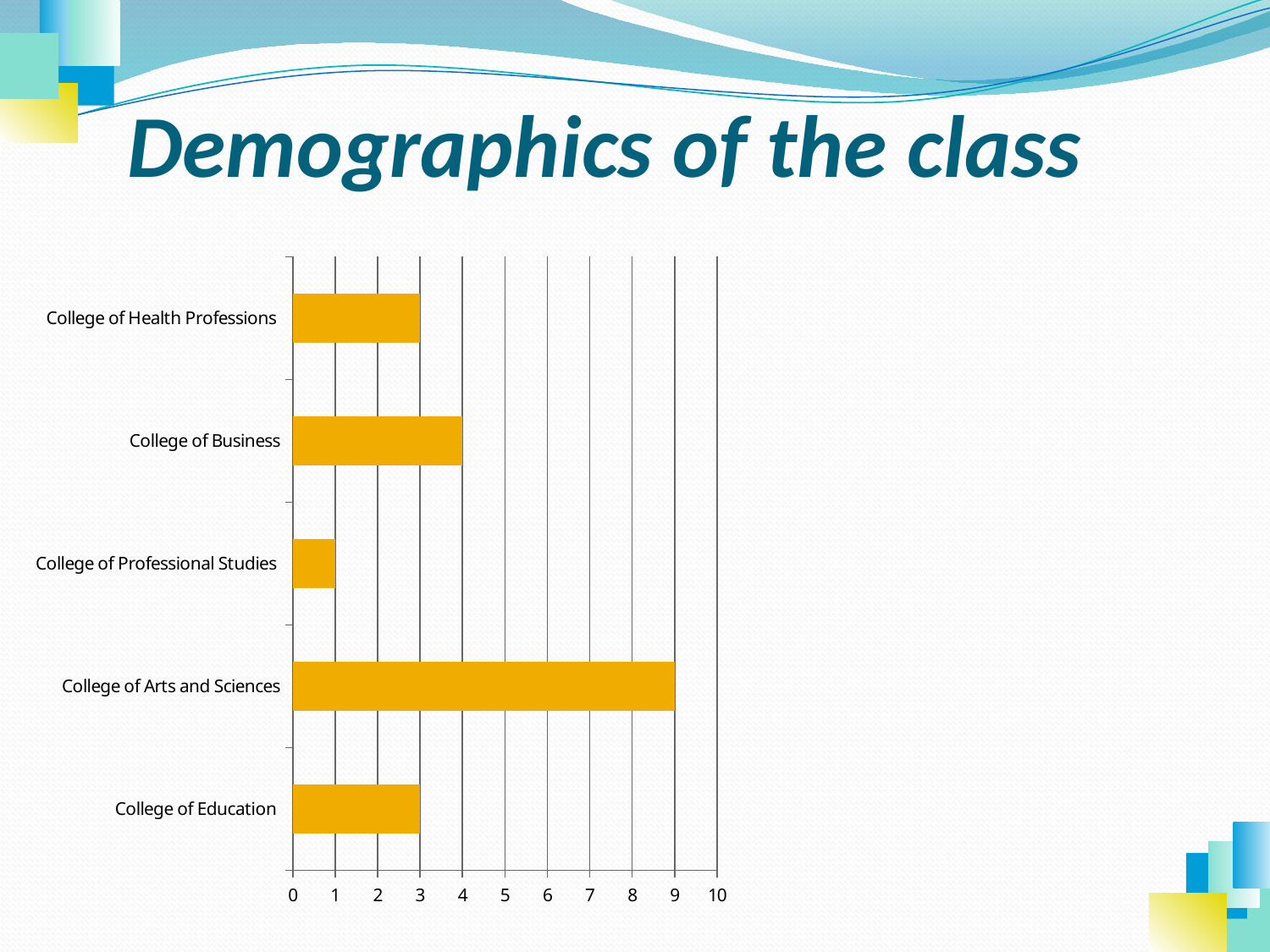
Which is larger, the value for College of Business or the value for College of Health Professions? College of Business What is the value for College of Business? 4 Which college has the lowest value on the chart? College of Professional Studies What is the value for College of Education? 3 What is the value for College of Professional Studies? 1 What is the value for College of Arts and Sciences? 9 How many colleges are listed on the chart? 5 Is the value for College of Arts and Sciences greater or less than 5? greater What is the difference between the values for College of Arts and Sciences and College of Business? 5 What is the title of the slide containing the chart? Demographics of the class What kind of chart is shown on the slide? bar chart Which college has the highest value on the chart? College of Arts and Sciences